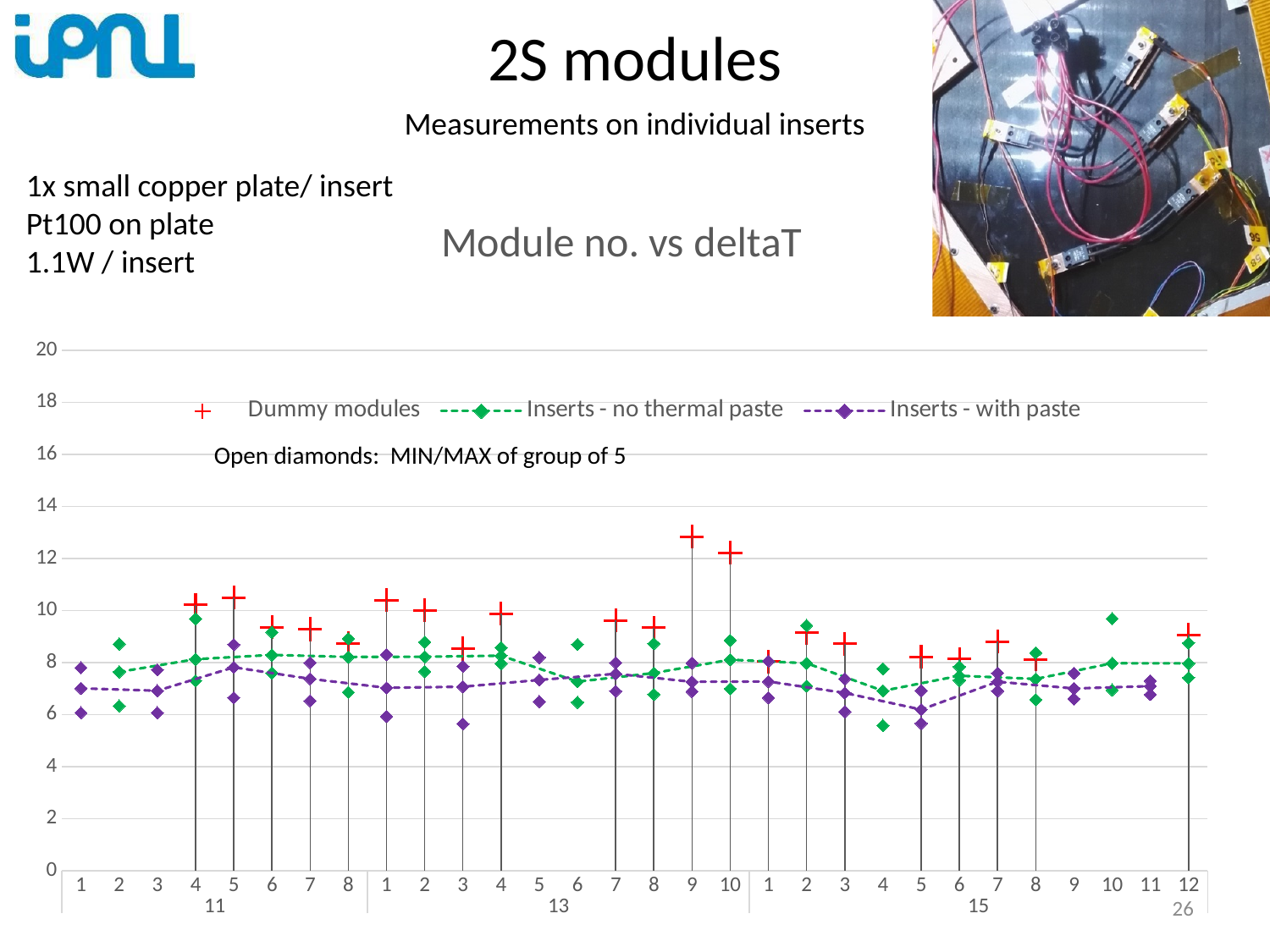
Is the Dummy modules value for module 5 of group 15 greater or less than 6? greater How many series does the chart legend list? 3 Which series is plotted with red plus markers? Dummy modules Is the Dummy modules value for module 4 of group 11 greater or less than 8? greater Is the Dummy modules value for module 9 of group 13 greater or less than 12? greater How many module groups are labelled along the x axis? 3 For the Dummy modules series, which module has the highest deltaT? Module 9 of group 13 How many module positions are plotted along the x axis in total? 30 What is the title of the chart? Module no. vs deltaT What is the maximum value shown on the y axis? 20 Which is larger for the Dummy modules series: module 9 of group 13 or module 4 of group 11? Module 9 of group 13